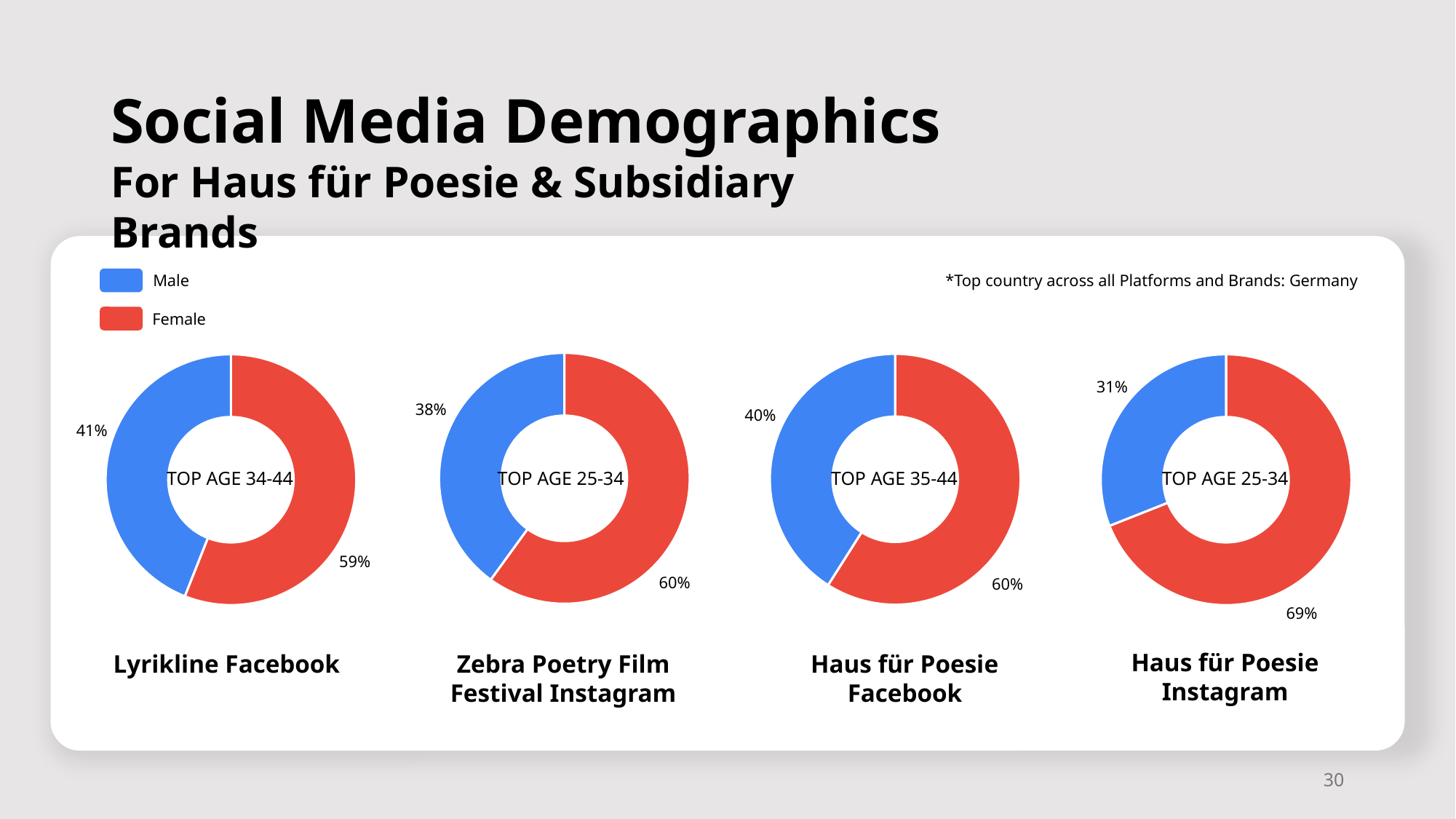
How many series does the legend list? 2 In the Lyrikline Facebook chart, what percentage is Male? 41% Across the four charts, which brand/platform has the lowest Male percentage? Haus für Poesie Instagram In the Haus für Poesie Instagram chart, what percentage is Male? 31% What is the top age group shown in the centre of the Haus für Poesie Facebook chart? 35-44 In the Haus für Poesie Instagram chart, what percentage is Female? 69% In the Zebra Poetry Film Festival Instagram chart, what percentage is Male? 38% What kind of chart is used for the Lyrikline Facebook data? Pie chart (donut) In the Lyrikline Facebook chart, what percentage is Female? 59% In the Lyrikline Facebook chart, which is larger, Male or Female? Female In the Haus für Poesie Instagram chart, what is the difference between the Female and Male percentages? 38% In the Haus für Poesie Facebook chart, what percentage is Female? 60%